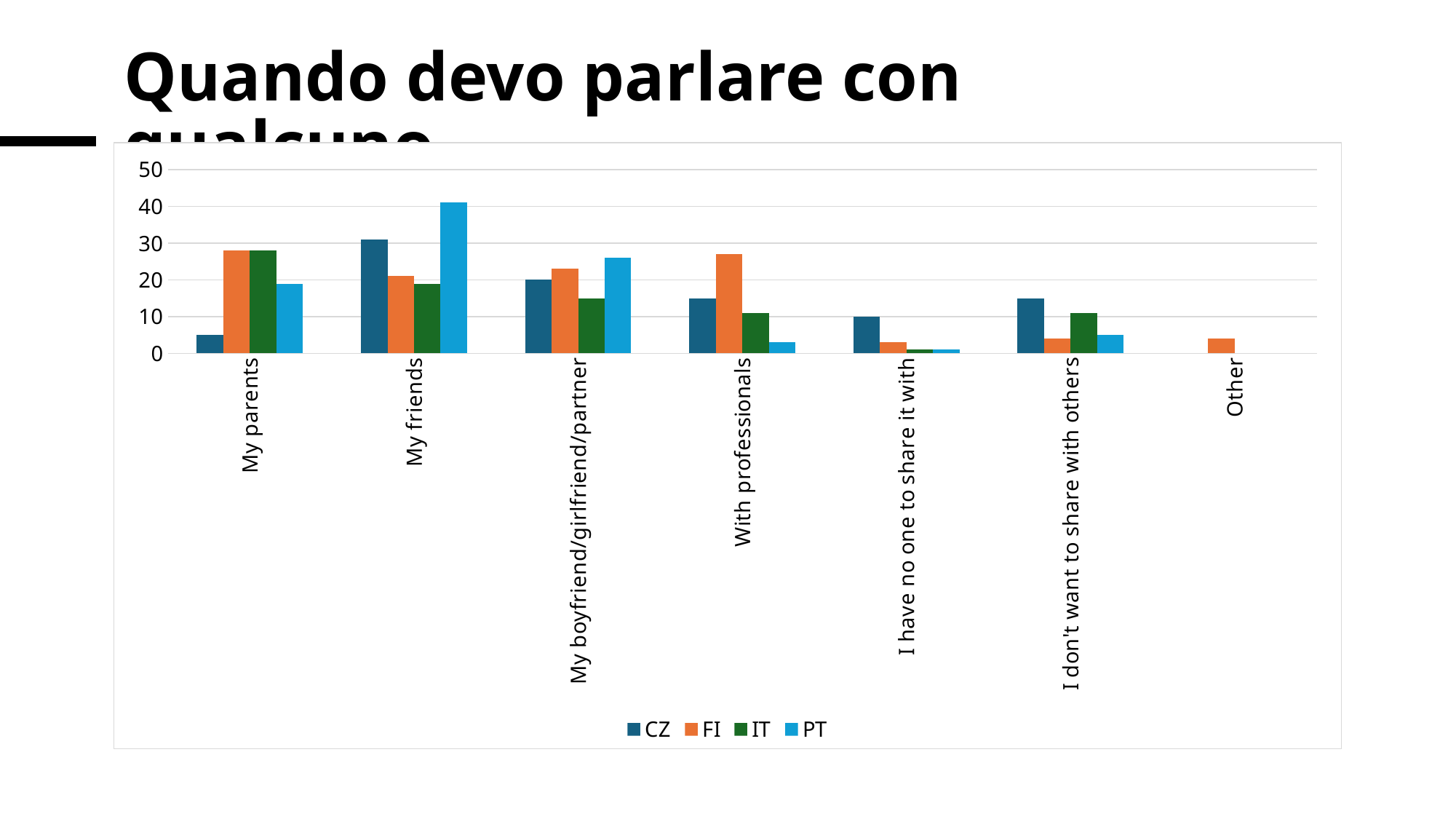
For 'With professionals', which is larger: the FI value or the PT value? FI Is the FI value for 'With professionals' greater or less than 20? greater For the category 'With professionals', which series has the lowest bar? PT For which category is the PT bar the highest? My friends How many series does the legend list? 4 For the category 'My friends', which series has the highest bar? PT How many categories are shown on the x axis? 7 For 'My friends', which is larger: the CZ value or the FI value? CZ Which series are listed in the legend? CZ, FI, IT, PT Is the PT value for 'My friends' greater or less than 30? greater Is the CZ value for 'My parents' greater or less than 10? less What kind of chart is shown on the slide? bar chart